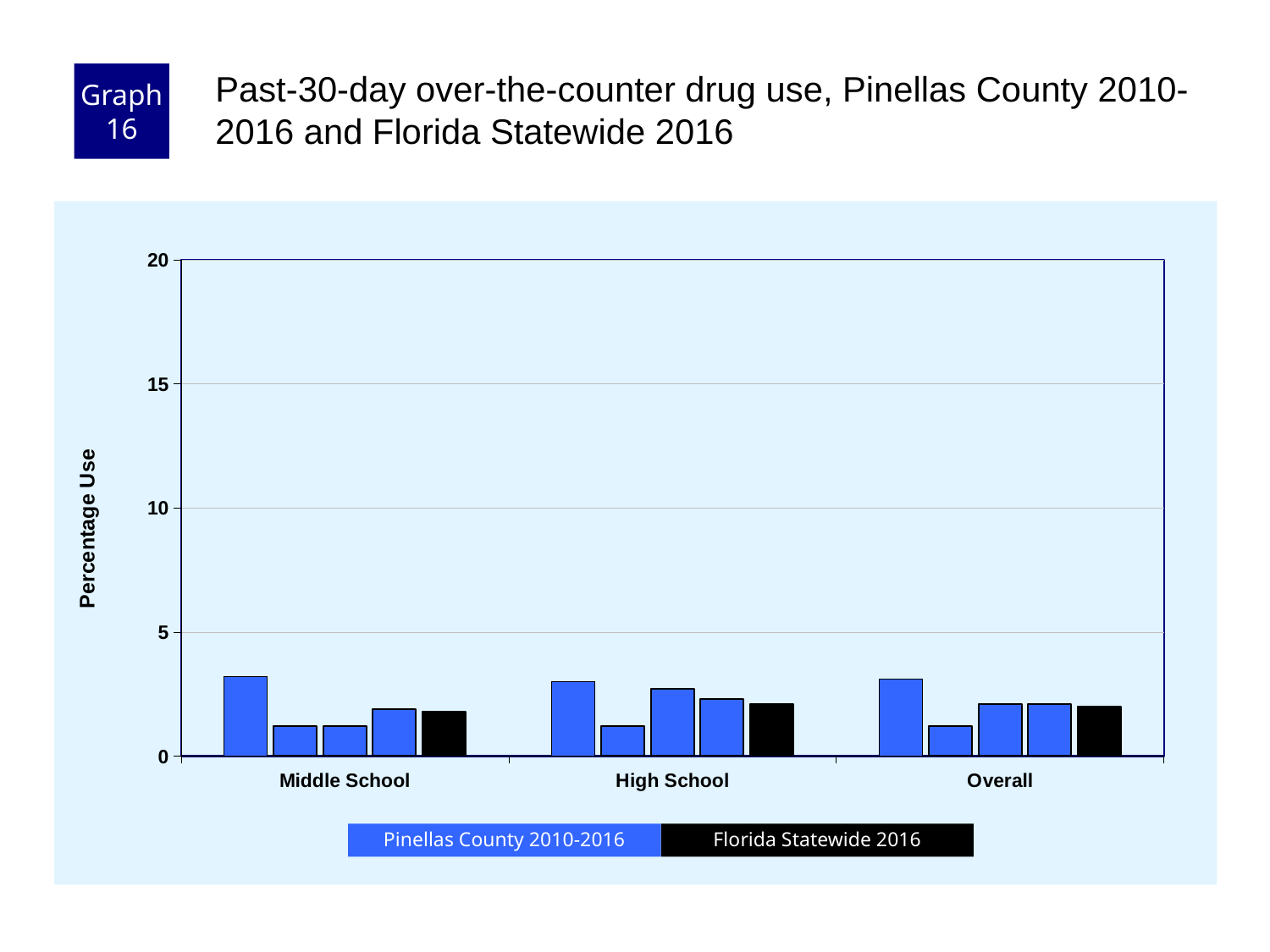
How many school-level categories are shown on the x axis? 3 In the Middle School group, which is larger: the first (leftmost) Pinellas County bar or the Florida Statewide 2016 bar? the first Pinellas County bar In the High School group, which is larger: the first (leftmost) Pinellas County bar or the Florida Statewide 2016 bar? the first Pinellas County bar How many series does the legend list? 2 Is the tallest Pinellas County bar in the Middle School group greater or less than 5? less What kind of chart is shown on the slide? bar chart What is the label on the y axis? Percentage Use Is the value for the Florida Statewide 2016 bar in the High School group greater or less than 5? less Is the Florida Statewide 2016 bar in the Overall group greater or less than 10? less Which colour represents Florida Statewide 2016 in the legend? black Within the Middle School group, which bar is the tallest? the first (leftmost) Pinellas County bar In the Overall group, which is larger: the first (leftmost) Pinellas County bar or the Florida Statewide 2016 bar? the first Pinellas County bar